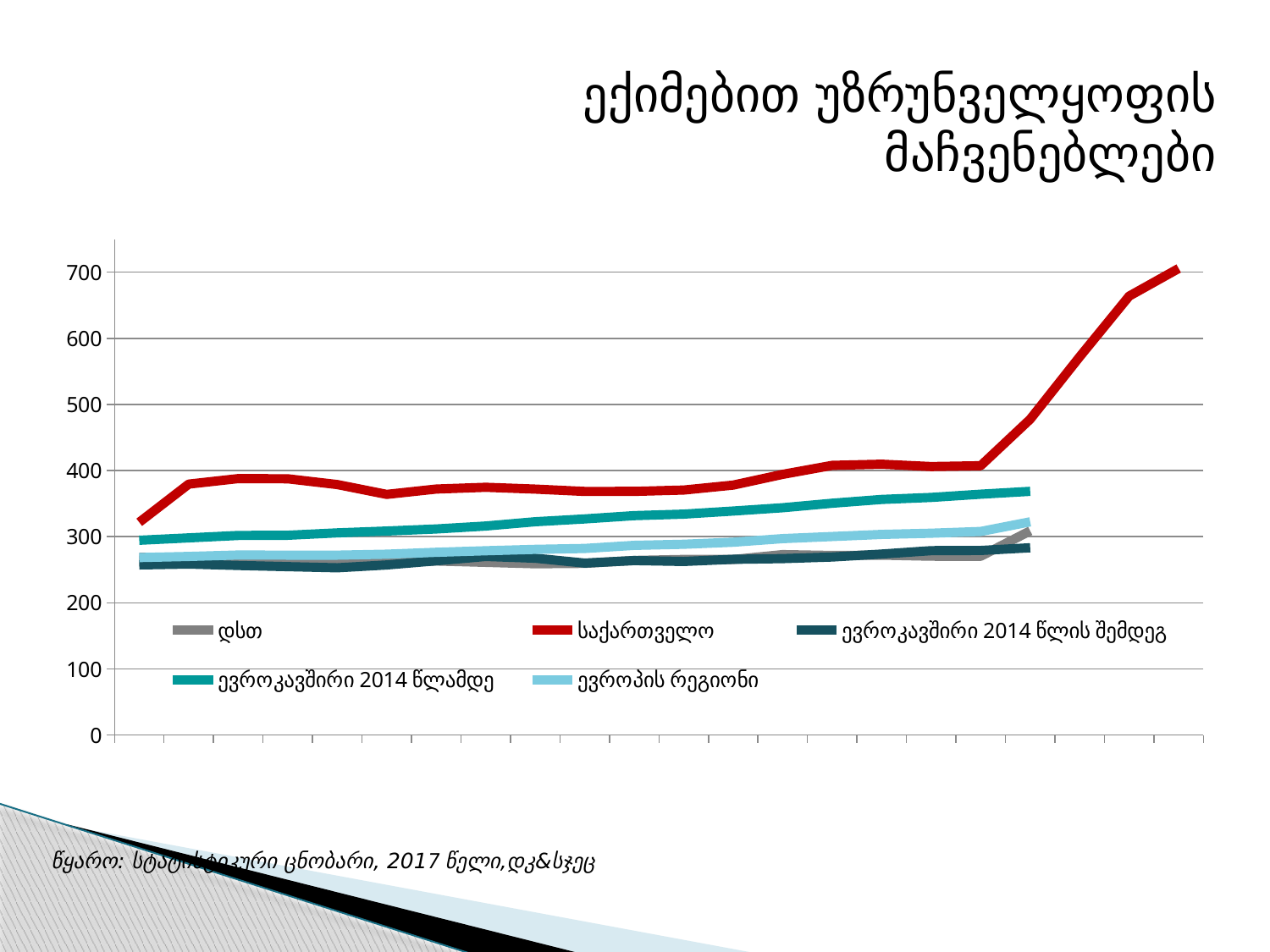
Which series reaches the highest value on the chart? საქართველო Is the final value for ევროკავშირი 2014 წლამდე greater or less than 300? greater What is the title of the slide? ექიმებით უზრუნველყოფის მაჩვენებლები Is the final value for ევროკავშირი 2014 წლის შემდეგ greater or less than 300? less Does the line for საქართველო rise or fall overall from left to right? rise What colour is the line for საქართველო? red Is the first value for საქართველო greater or less than 300? greater What kind of chart is shown on the slide? line chart How many series does the legend list? 5 At the right end of the chart, which is larger: the value for საქართველო or the value for ევროპის რეგიონი? საქართველო